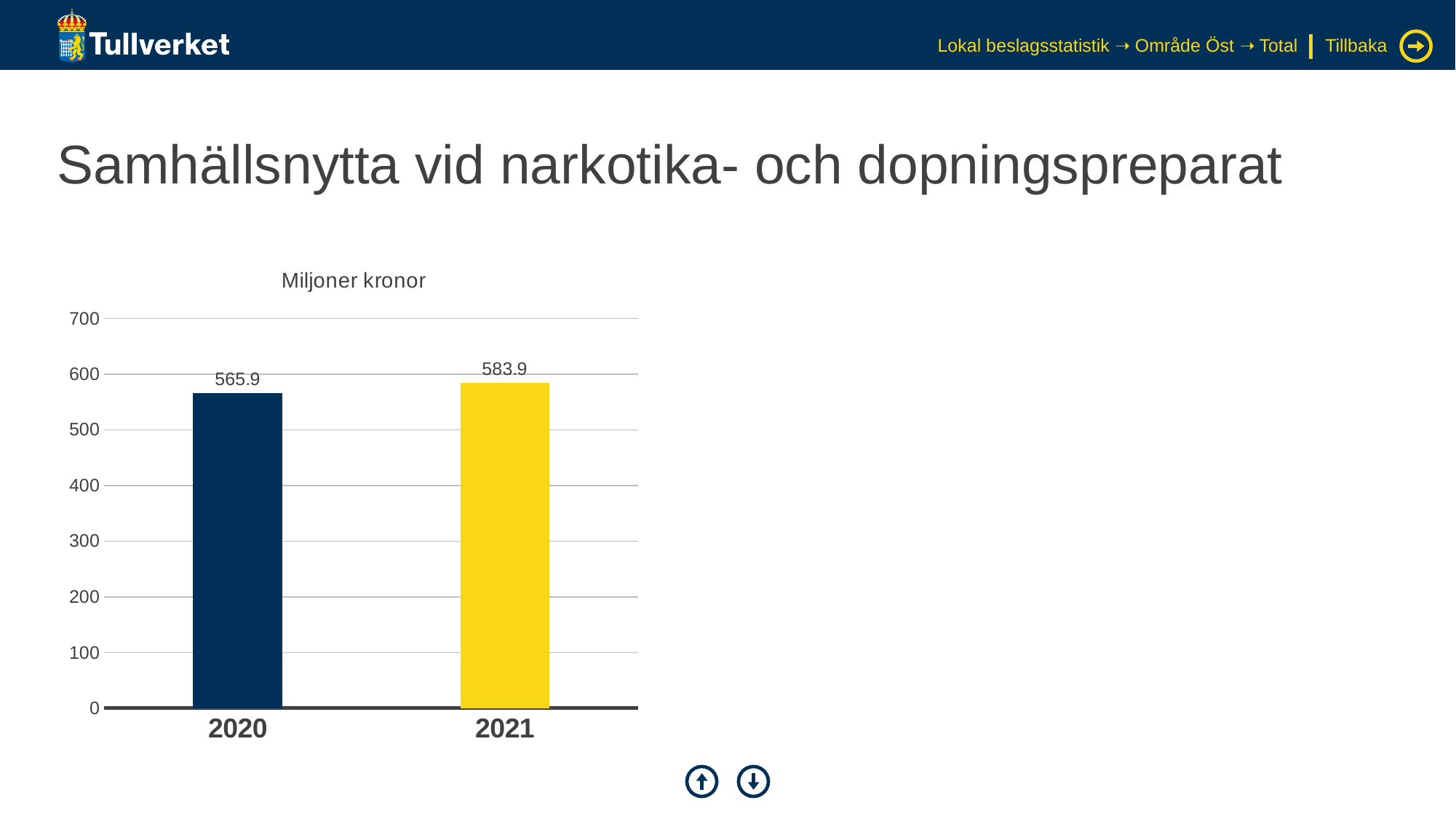
What is the value for 2020? 565.9 Do the values rise or fall from 2020 to 2021? rise What unit is given above the chart's y axis? Miljoner kronor What is the difference between the values for 2021 and 2020? 18.0 What is the value for 2021? 583.9 Which year has the lowest value? 2020 Is the value for 2021 greater or less than 600? less How many bars are shown in the chart? 2 Is the value for 2020 greater or less than 500? greater Which is larger, the value for 2020 or the value for 2021? 2021 What kind of chart is shown on the slide? bar chart Which year has the highest value? 2021